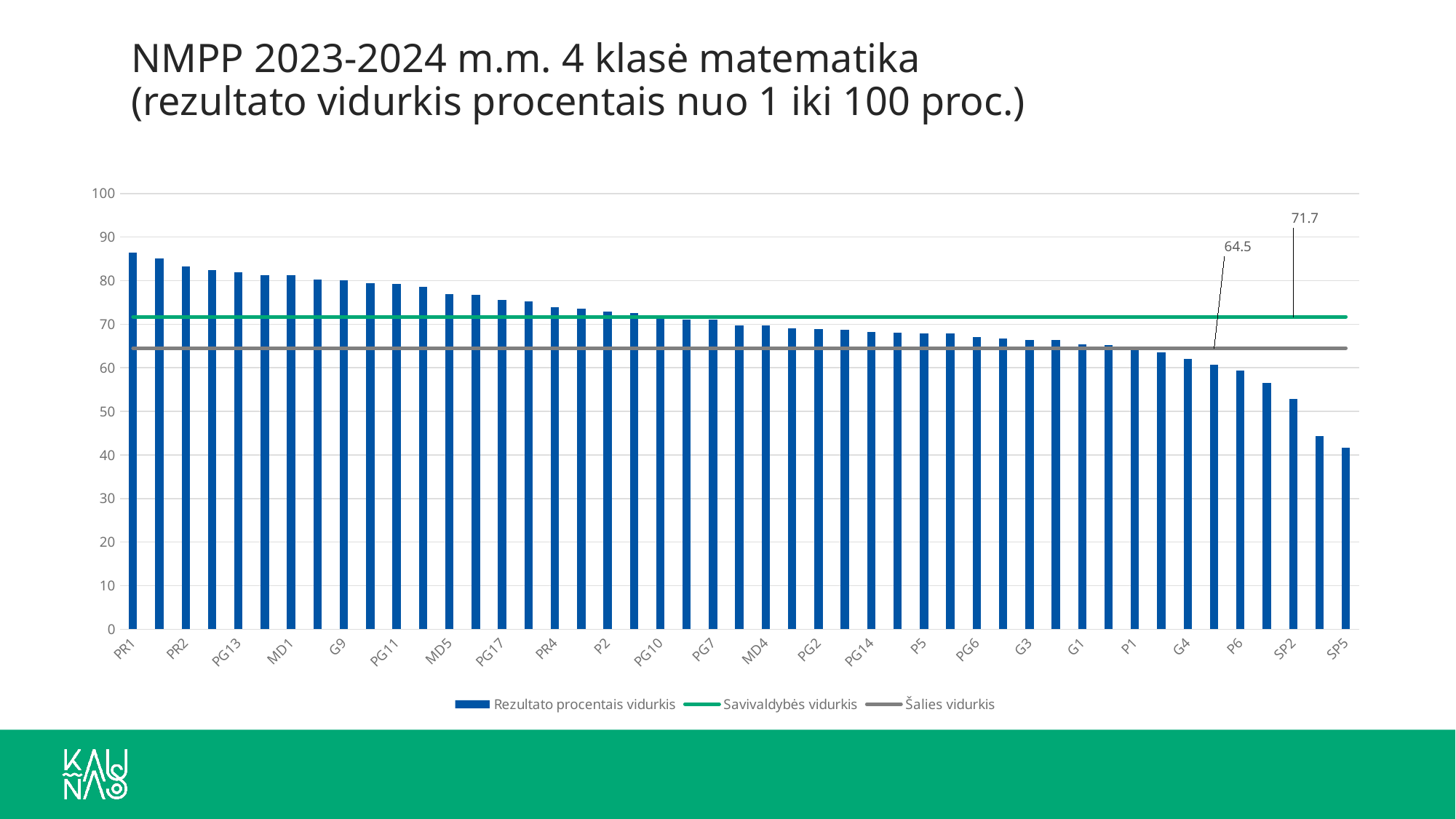
Do the bar values rise or fall from left to right along the x axis? fall Is the value for PR1 greater or less than 80? greater What is the value of the Savivaldybės vidurkis line? 71.7 What is the value of the Šalies vidurkis line? 64.5 Which category has the lowest Rezultato procentais vidurkis bar? SP5 Is the value for SP2 greater or less than 60? less How many series does the legend list? 3 What is the difference between the Savivaldybės vidurkis (71.7) and the Šalies vidurkis (64.5)? 7.2 What kind of chart is shown on the slide? bar chart Which category has the highest Rezultato procentais vidurkis bar? PR1 Is the value for SP5 greater or less than 50? less Which has a larger bar, PG13 or P6? PG13